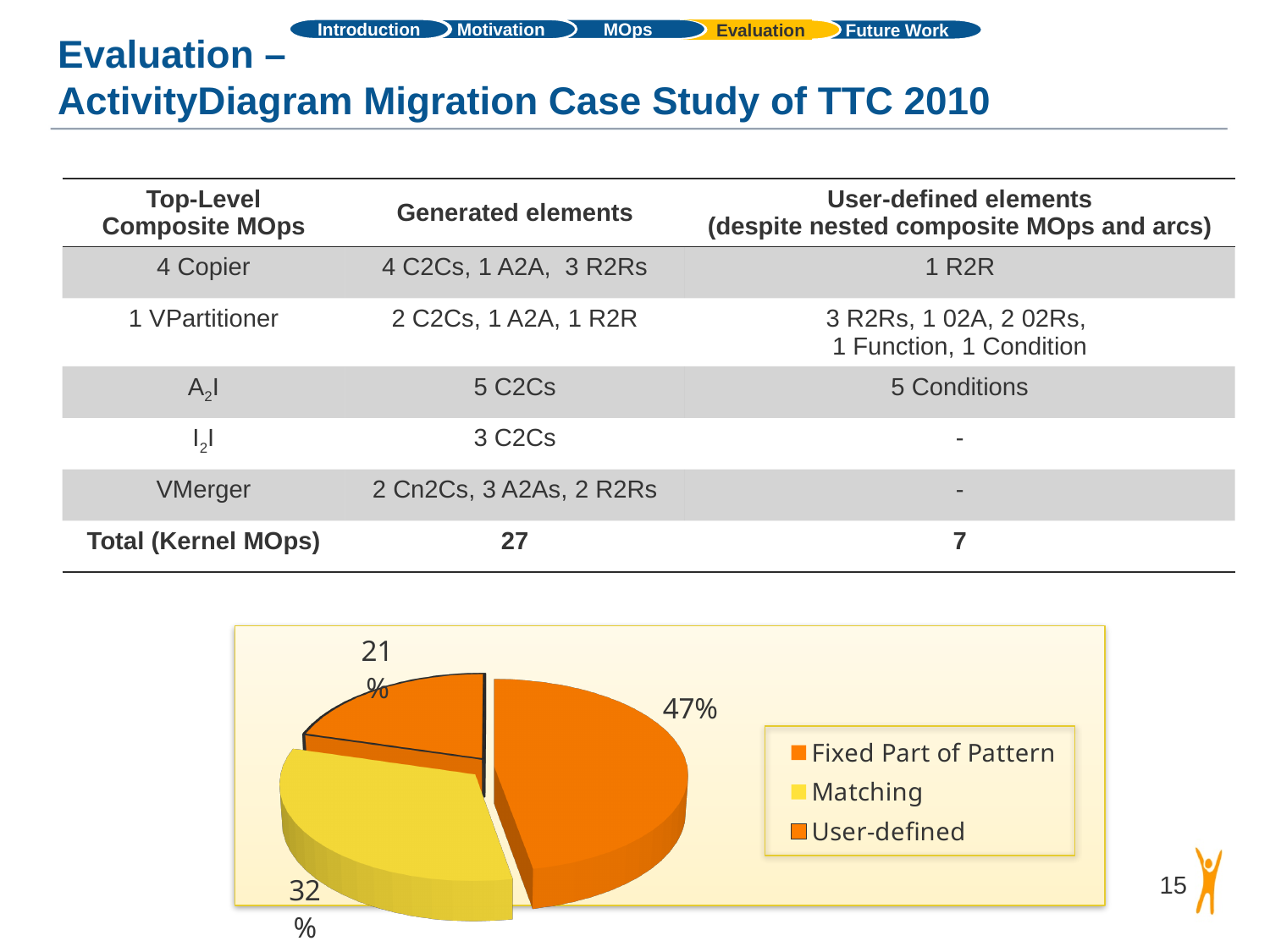
How many entries does the legend of the pie chart list? 3 What share of the pie does Fixed Part of Pattern take? 47% What is the difference in percentage points between the Matching slice and the User-defined slice? 11 Which slice of the pie chart is the largest? Fixed Part of Pattern How many slices does the pie chart have? 3 What is the difference in percentage points between the Fixed Part of Pattern slice and the Matching slice? 15 What share of the pie does Matching take? 32% Which slice of the pie chart is the smallest? User-defined Which is larger in the pie chart, Matching or User-defined? Matching What share of the pie does User-defined take? 21% What colour is the Matching slice in the pie chart? yellow What kind of chart is shown on the slide? pie chart